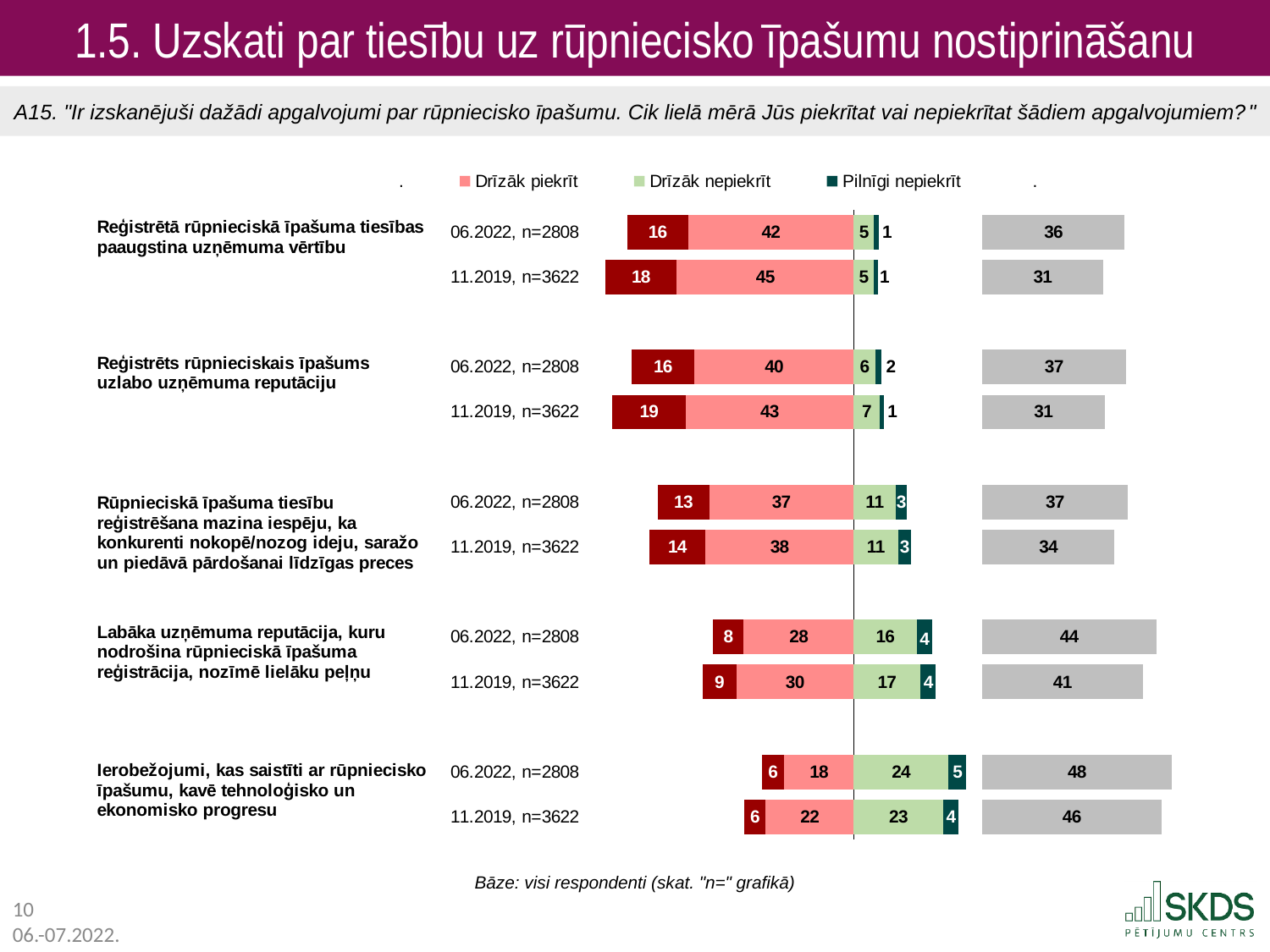
What value is shown in the grey bar for "Ierobežojumi, kas saistīti ar rūpniecisko īpašumu, kavē tehnoloģisko un ekonomisko progresu" in 06.2022, n=2808? 48 What is the "Drīzāk piekrīt" value for "Reģistrētā rūpnieciskā īpašuma tiesības paaugstina uzņēmuma vērtību" in 06.2022, n=2808? 42 How many statements are shown in the chart? 5 What is the total of the "Drīzāk nepiekrīt" and "Pilnīgi nepiekrīt" values for "Rūpnieciskā īpašuma tiesību reģistrēšana mazina iespēju, ka konkurenti nokopē/nozog ideju, saražo un piedāvā pārdošanai līdzīgas preces" in 06.2022, n=2808? 14 Which statement has the highest "Drīzāk piekrīt" value in 11.2019, n=3622? Reģistrētā rūpnieciskā īpašuma tiesības paaugstina uzņēmuma vērtību What is the difference between the "Drīzāk piekrīt" values for "Reģistrēts rūpnieciskais īpašums uzlabo uzņēmuma reputāciju" in 11.2019, n=3622 and 06.2022, n=2808? 3 What is the "Drīzāk nepiekrīt" value for "Ierobežojumi, kas saistīti ar rūpniecisko īpašumu, kavē tehnoloģisko un ekonomisko progresu" in 06.2022, n=2808? 24 What kind of chart is shown on the slide? Stacked bar chart Which statement has the lowest "Drīzāk piekrīt" value in 06.2022, n=2808? Ierobežojumi, kas saistīti ar rūpniecisko īpašumu, kavē tehnoloģisko un ekonomisko progresu Which is larger for "Ierobežojumi, kas saistīti ar rūpniecisko īpašumu, kavē tehnoloģisko un ekonomisko progresu" in 11.2019, n=3622: the "Drīzāk piekrīt" value or the "Drīzāk nepiekrīt" value? Drīzāk nepiekrīt What is the "Pilnīgi nepiekrīt" value for "Labāka uzņēmuma reputācija, kuru nodrošina rūpnieciskā īpašuma reģistrācija, nozīmē lielāku peļņu" in 11.2019, n=3622? 4 Which legend entry is shown in dark green? Pilnīgi nepiekrīt